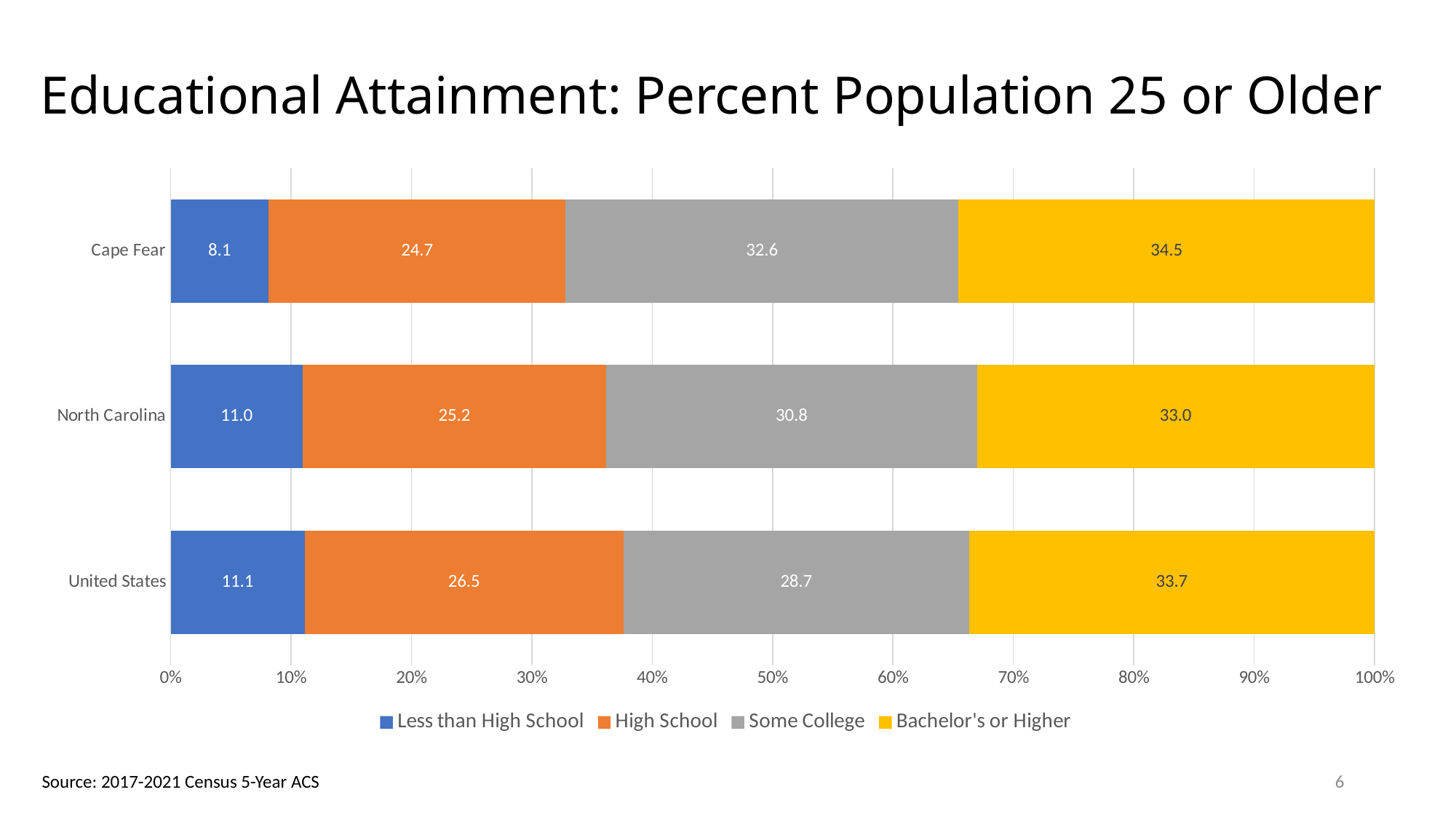
What is the title of the chart? Educational Attainment: Percent Population 25 or Older What is the value for Some College for Cape Fear? 32.6 Which region has the highest value for Bachelor's or Higher? Cape Fear How many series does the legend list? 4 What is the difference between the High School values for United States and Cape Fear? 1.8 Which colour represents High School in the legend? Orange What kind of chart is shown on the slide? Stacked bar chart Which region has the lowest value for Less than High School? Cape Fear How many regions are shown on the chart? 3 What is the value for Less than High School for North Carolina? 11.0 Which is larger: Some College for North Carolina or Some College for United States? North Carolina What is the value for Bachelor's or Higher for United States? 33.7